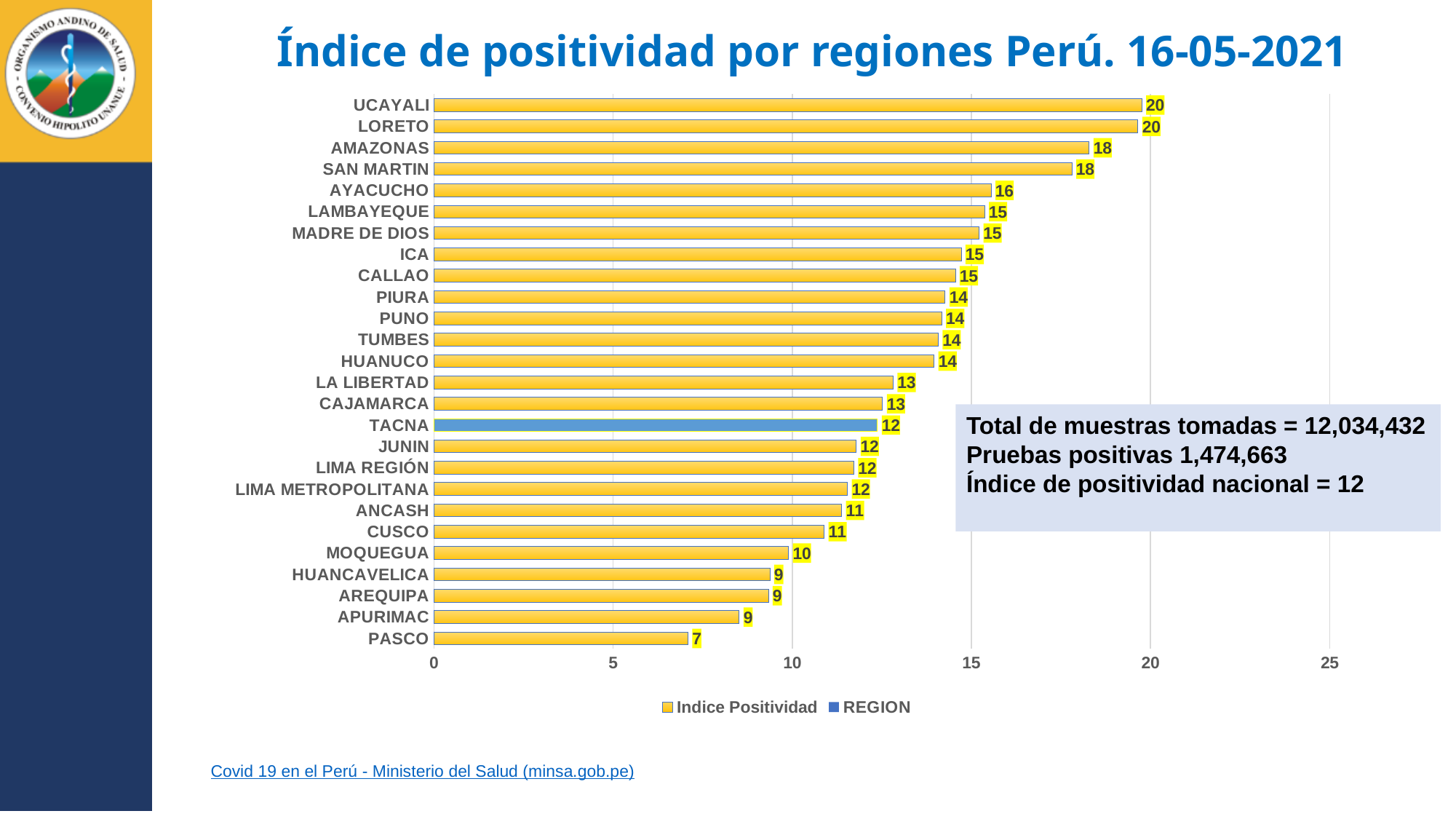
How many series does the legend list? 2 What is the positivity index value shown for TACNA? 12 Which region has a higher positivity index, AYACUCHO or ANCASH? AYACUCHO What is the difference between the positivity index of UCAYALI and PASCO? 13 What kind of chart is shown on the slide? Bar chart How many regions are shown on the chart? 26 Is the value for LA LIBERTAD greater or less than 15? less What is the positivity index value shown for AYACUCHO? 16 Which region has the lowest positivity index on the chart? PASCO What is the positivity index value shown for MOQUEGUA? 10 What is the positivity index value shown for PASCO? 7 What is the difference between the positivity index of AMAZONAS and CUSCO? 7